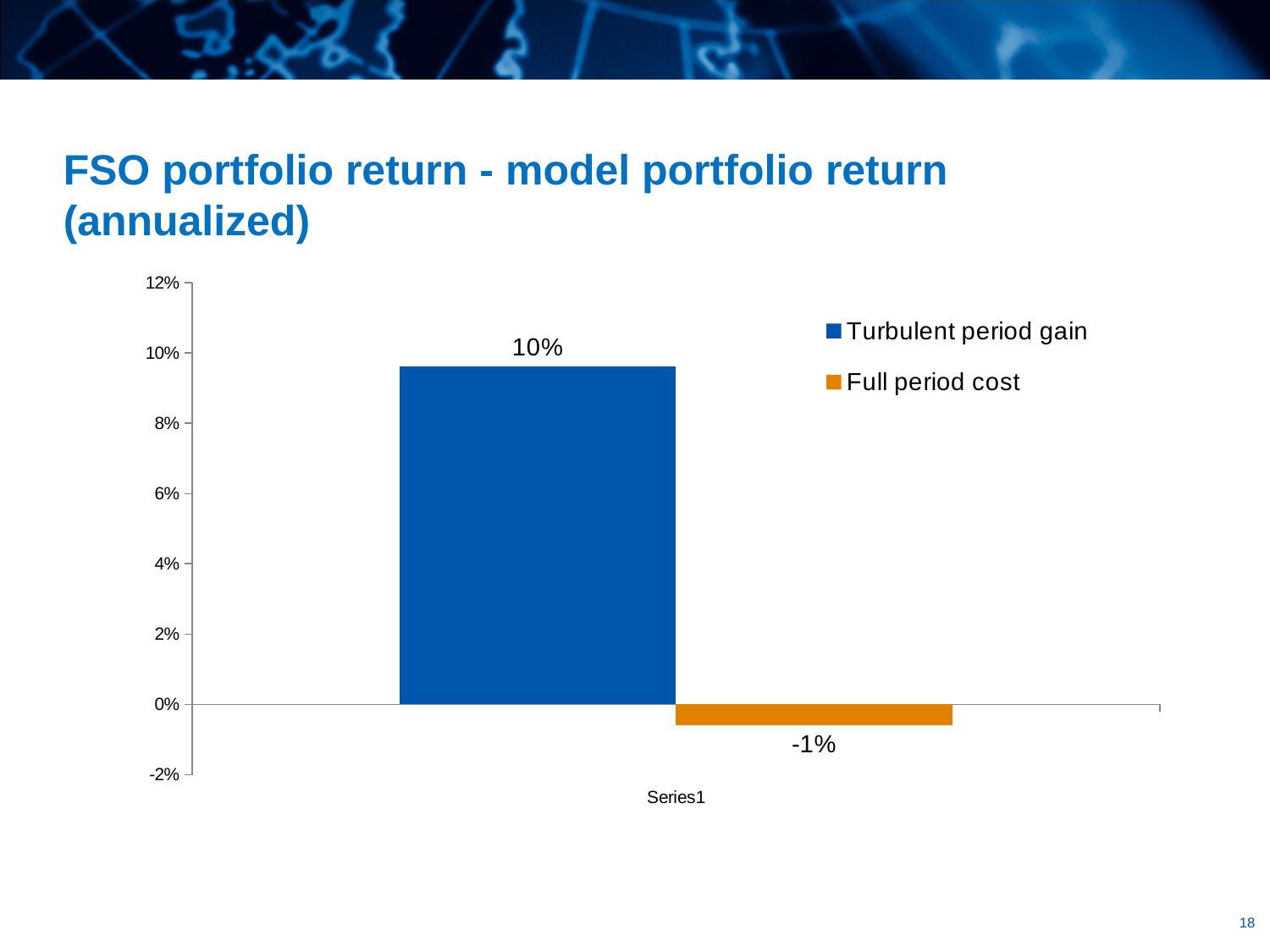
Which series has the higher value, Turbulent period gain or Full period cost? Turbulent period gain Which series has the lowest value? Full period cost What is the value for Turbulent period gain? 10% What is the title of the chart? FSO portfolio return - model portfolio return (annualized) What is the value for Full period cost? -1% What is the category label shown on the x axis? Series1 What kind of chart is shown on the slide? Bar chart Is the value for Turbulent period gain greater or less than 8%? greater What colour is the bar for Full period cost? Orange What is the difference between the Turbulent period gain value and the Full period cost value? 11% How many series does the legend list? 2 Is the value for Full period cost greater or less than 0%? less